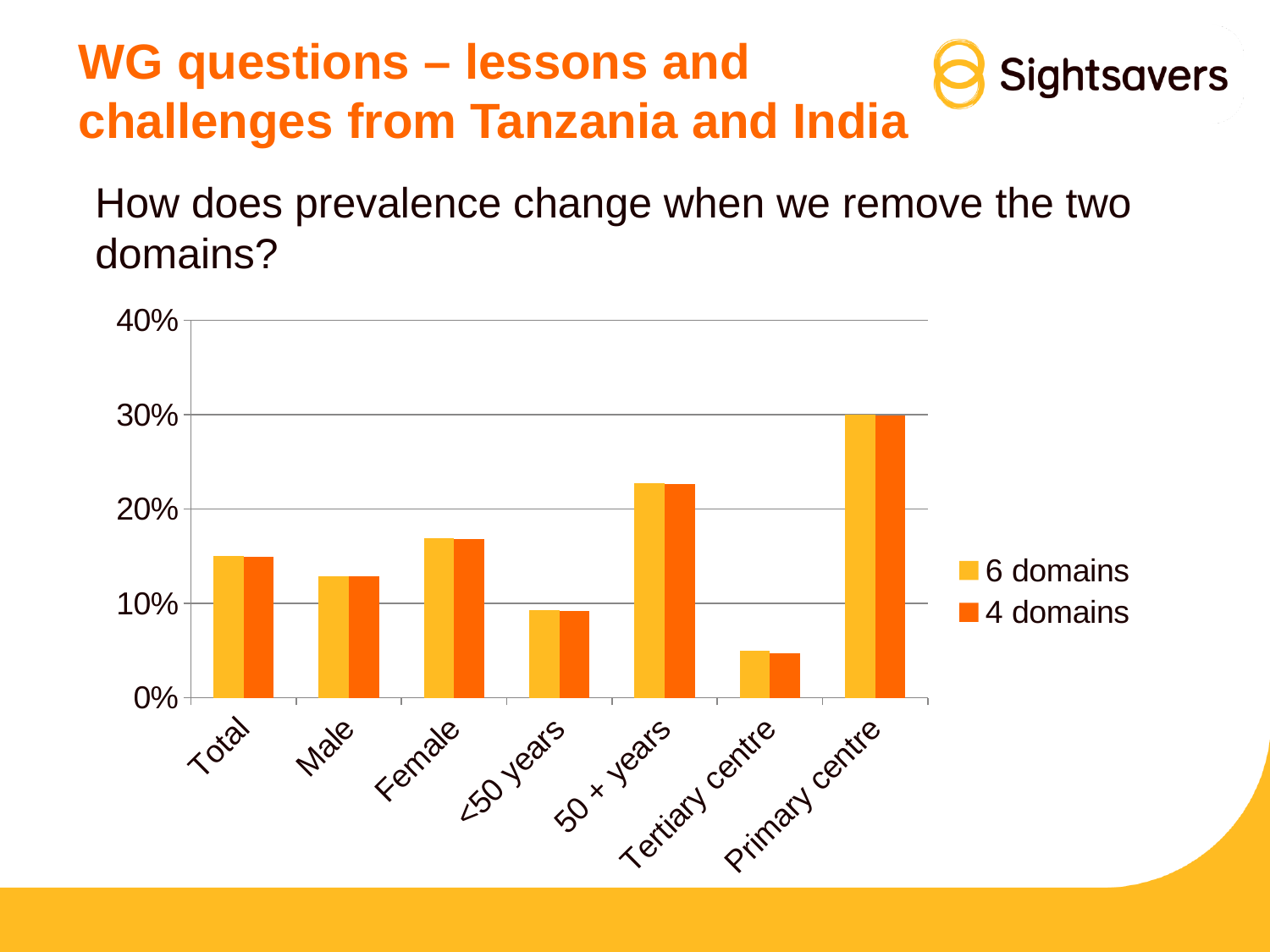
Is the 6 domains value for 50 + years greater or less than 20%? greater Which is larger for the 4 domains series: 50 + years or <50 years? 50 + years What kind of chart is shown on the slide? bar chart Is the 4 domains value for Female greater or less than 20%? less Is the 4 domains value for <50 years greater or less than 10%? less What are the two series named in the legend? 6 domains and 4 domains How many series does the legend list? 2 How many categories are shown on the x axis? 7 Which category has the lowest prevalence? Tertiary centre Which category has the highest prevalence? Primary centre Which is larger for the 6 domains series: Female or Male? Female